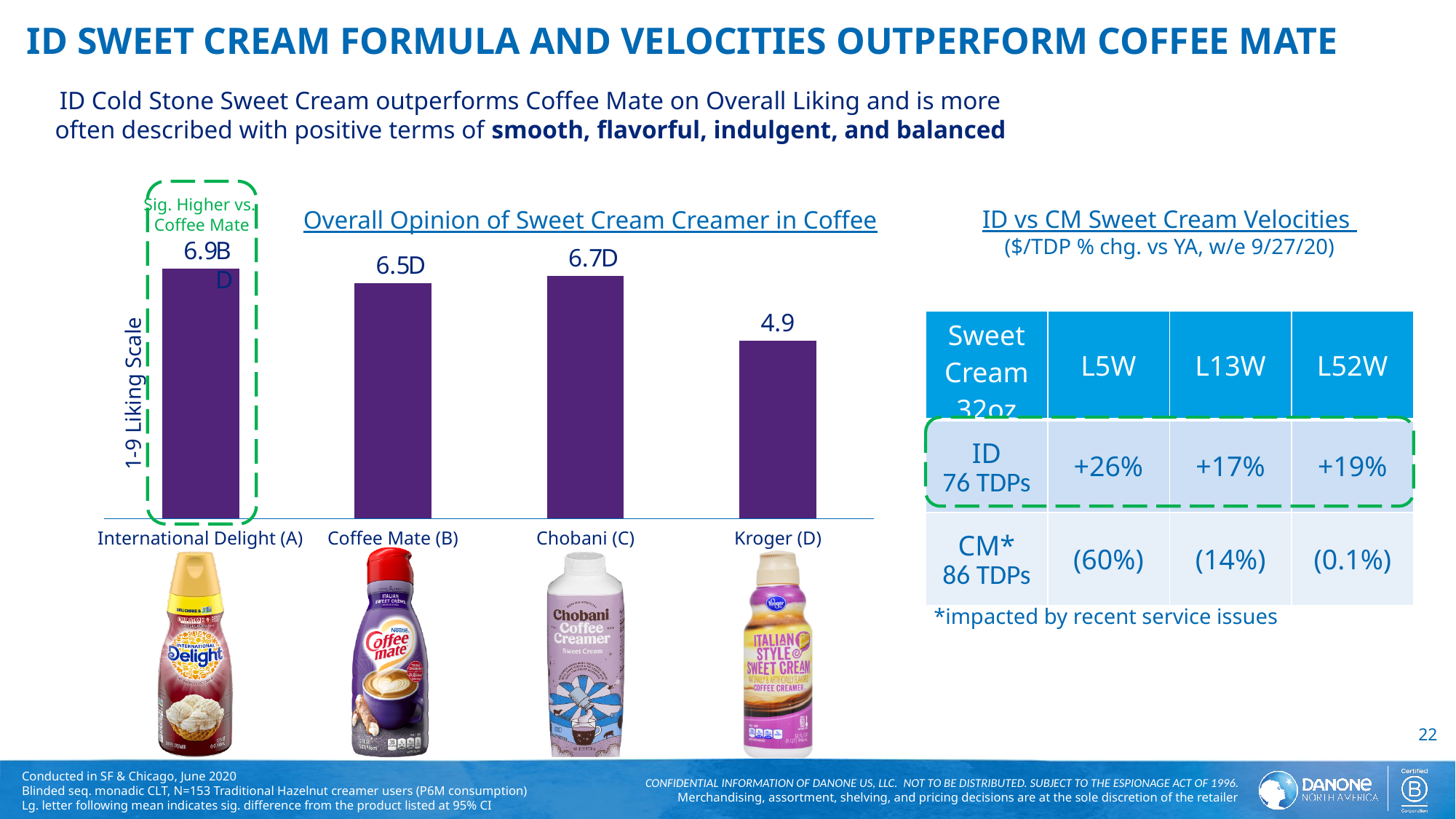
What type of chart is used to show the Overall Opinion of Sweet Cream Creamer in Coffee? Bar chart How many products are plotted in the Overall Opinion of Sweet Cream Creamer in Coffee chart? 4 What liking score is shown for International Delight (A) in the Overall Opinion chart? 6.9 What is the label on the vertical axis of the Overall Opinion chart? 1-9 Liking Scale What liking score is shown for Coffee Mate (B) in the Overall Opinion chart? 6.5 Which product has the lowest liking score in the Overall Opinion chart? Kroger (D) In the Overall Opinion chart, what is the difference between the scores of International Delight (A) and Coffee Mate (B)? 0.4 What liking score is shown for Kroger (D) in the Overall Opinion chart? 4.9 What liking score is shown for Chobani (C) in the Overall Opinion chart? 6.7 In the Overall Opinion chart, which scores higher: Chobani (C) or Coffee Mate (B)? Chobani (C) Which product has the highest liking score in the Overall Opinion chart? International Delight (A) In the Overall Opinion chart, how much higher is International Delight (A)'s score than Kroger (D)'s? 2.0